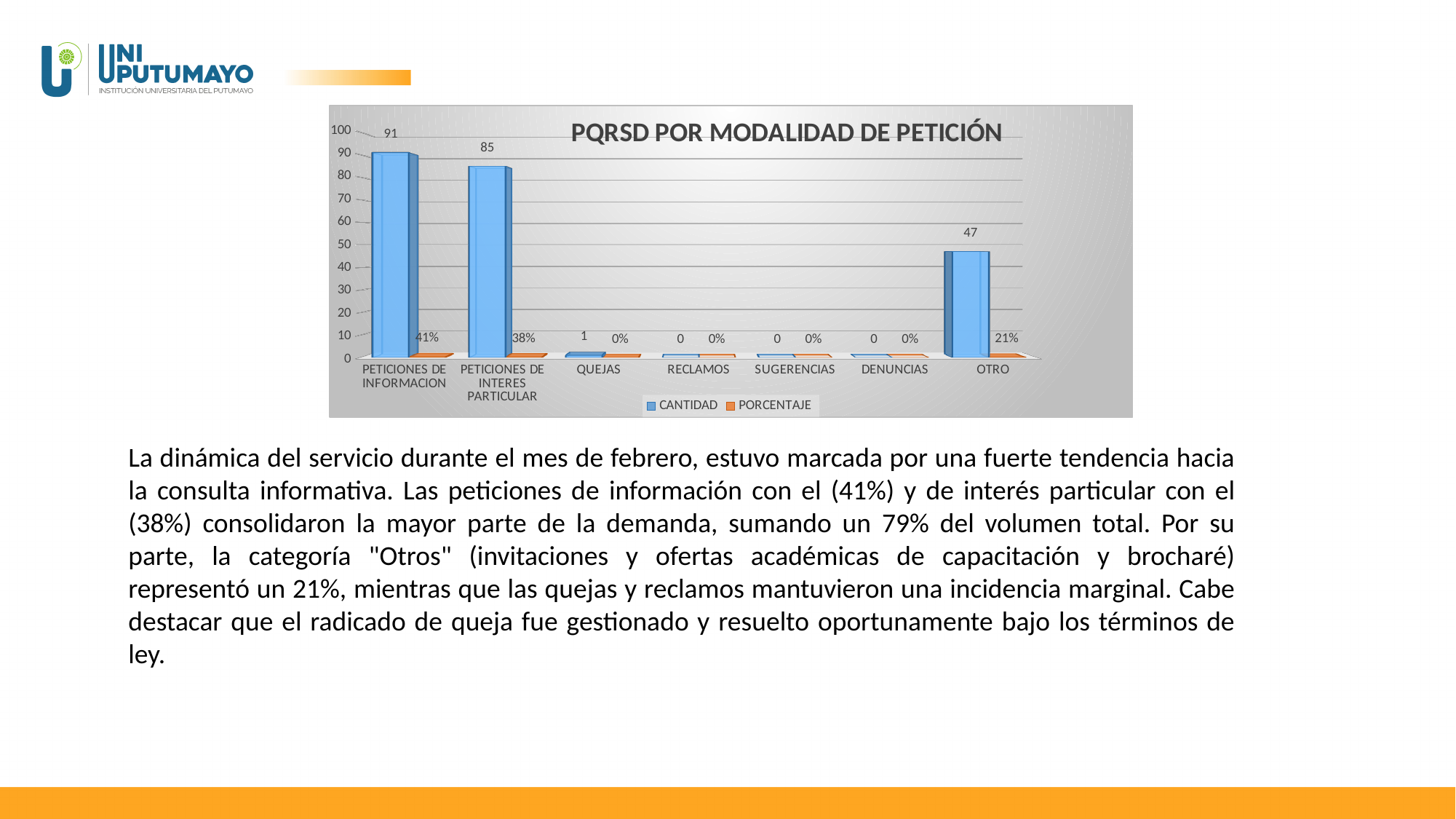
What is the CANTIDAD value for QUEJAS? 1 Is the CANTIDAD value for OTRO greater or less than 50? less Which category has the highest CANTIDAD value? PETICIONES DE INFORMACION What is the CANTIDAD value for PETICIONES DE INFORMACION? 91 Which has a larger CANTIDAD value, OTRO or QUEJAS? OTRO What is the PORCENTAJE value for OTRO? 21% What kind of chart is shown on the slide? bar chart What is the difference in CANTIDAD between PETICIONES DE INFORMACION and PETICIONES DE INTERES PARTICULAR? 6 How many series does the legend list? 2 How many categories are shown on the x axis? 7 What is the CANTIDAD value for PETICIONES DE INTERES PARTICULAR? 85 What is the title of the chart? PQRSD POR MODALIDAD DE PETICIÓN